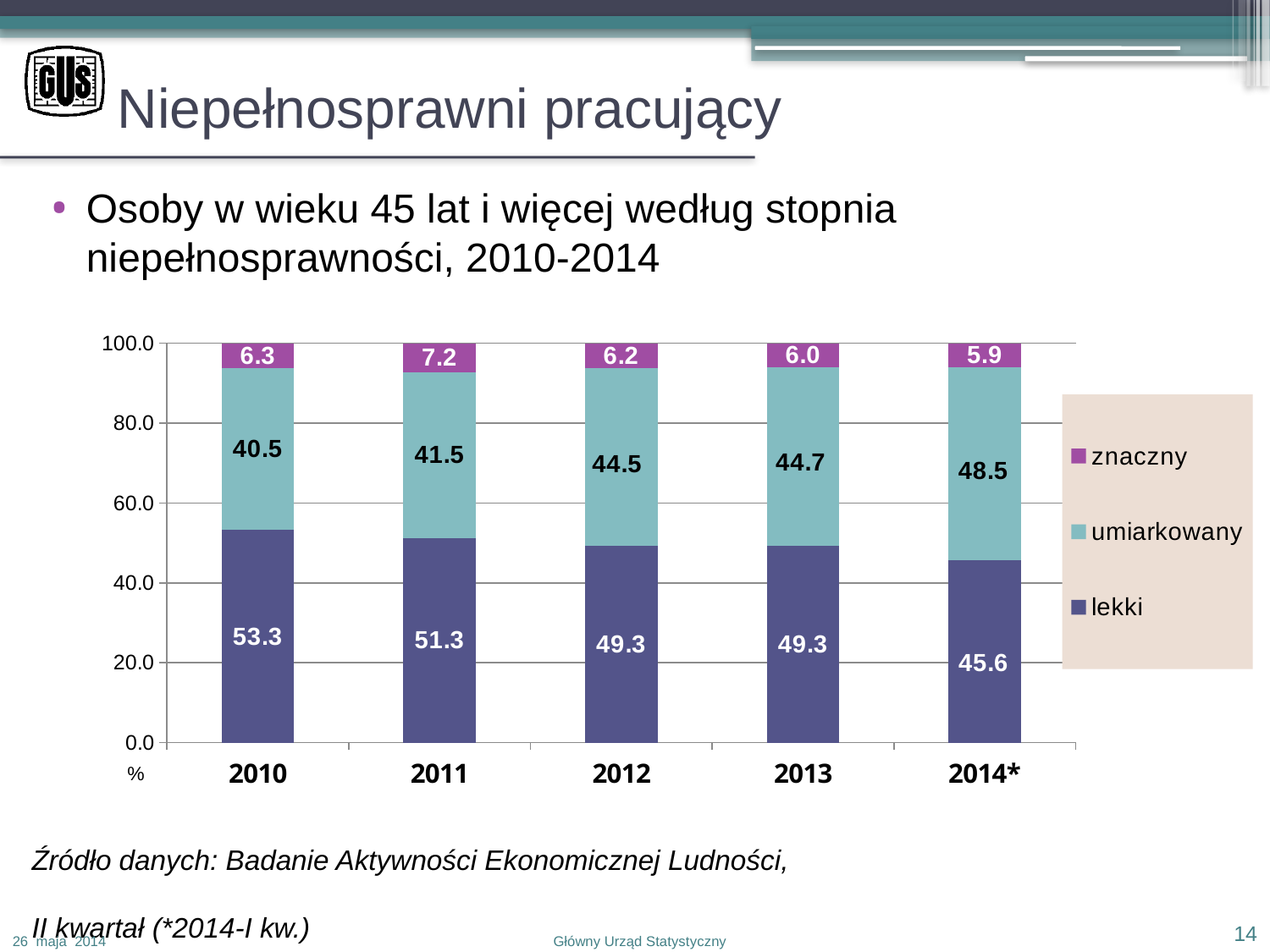
What is the value for "umiarkowany" in 2014*? 48.5 Which is larger, the "umiarkowany" value in 2012 or in 2013? 2013 In which year is the "znaczny" value highest? 2011 What is the difference between the "lekki" values for 2010 and 2014*? 7.7 How many years are shown on the x axis? 5 Does the "umiarkowany" value rise or fall from 2010 to 2014*? rise What kind of chart is shown on the slide? stacked bar chart What is the value for "lekki" in 2010? 53.3 What is the value for "znaczny" in 2011? 7.2 What is the total of the stacked bar for 2013? 100.0 How many series does the legend list? 3 In which year is the "lekki" value lowest? 2014*